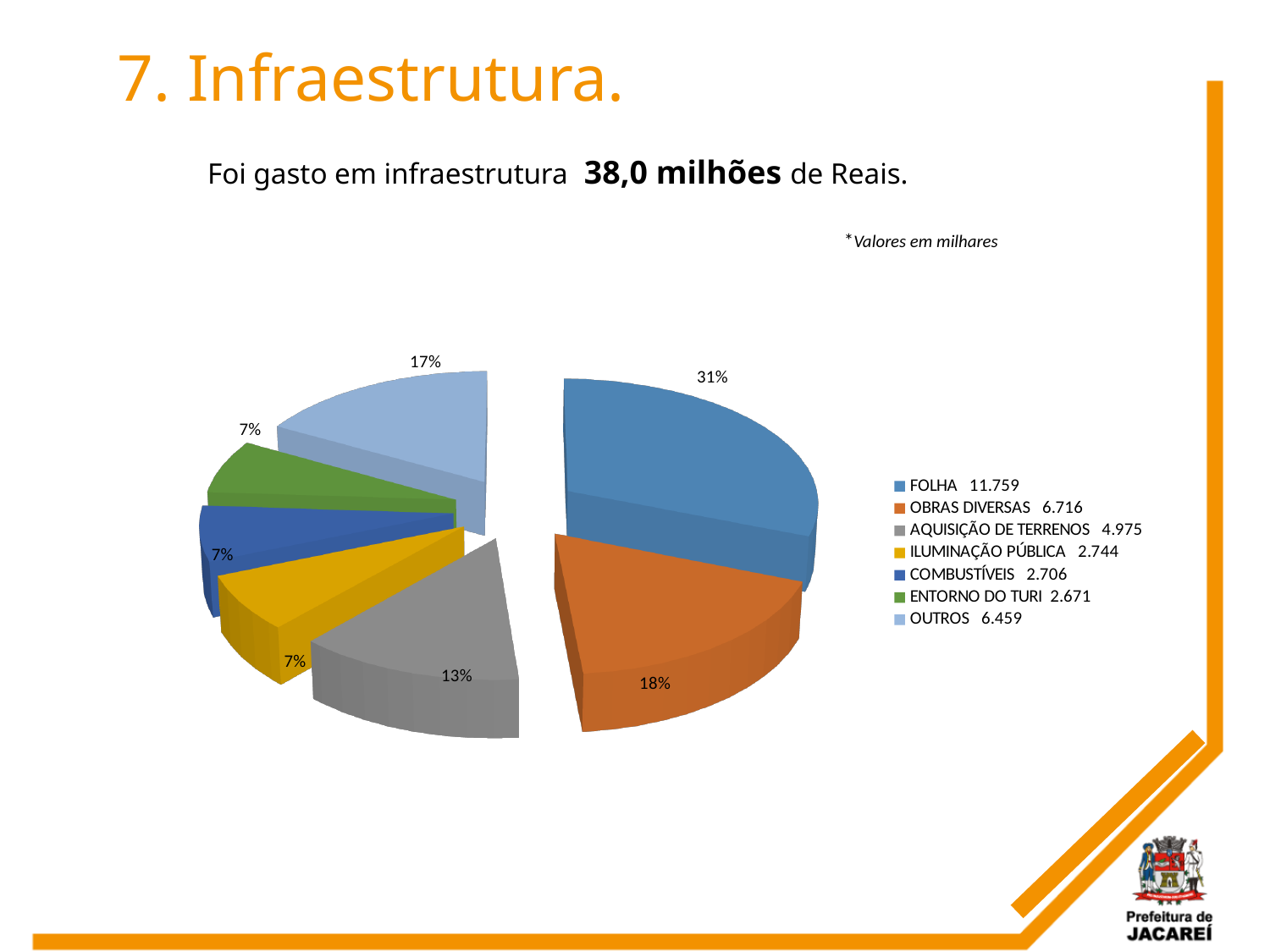
What colour is the slice for ILUMINAÇÃO PÚBLICA? yellow What value does the legend give for AQUISIÇÃO DE TERRENOS? 4.975 Which is larger, the value for OBRAS DIVERSAS or the value for OUTROS? OBRAS DIVERSAS What share of the pie does FOLHA represent? 31% What value does the legend give for FOLHA? 11.759 What kind of chart is shown on the slide? pie chart Which category has the smallest value according to the legend? ENTORNO DO TURI How many slices does the pie chart have? 7 What value does the legend give for OUTROS? 6.459 What is the difference between the values for FOLHA and OBRAS DIVERSAS? 5.043 Which category has the largest value in the pie chart? FOLHA What share of the pie does OBRAS DIVERSAS represent? 18%